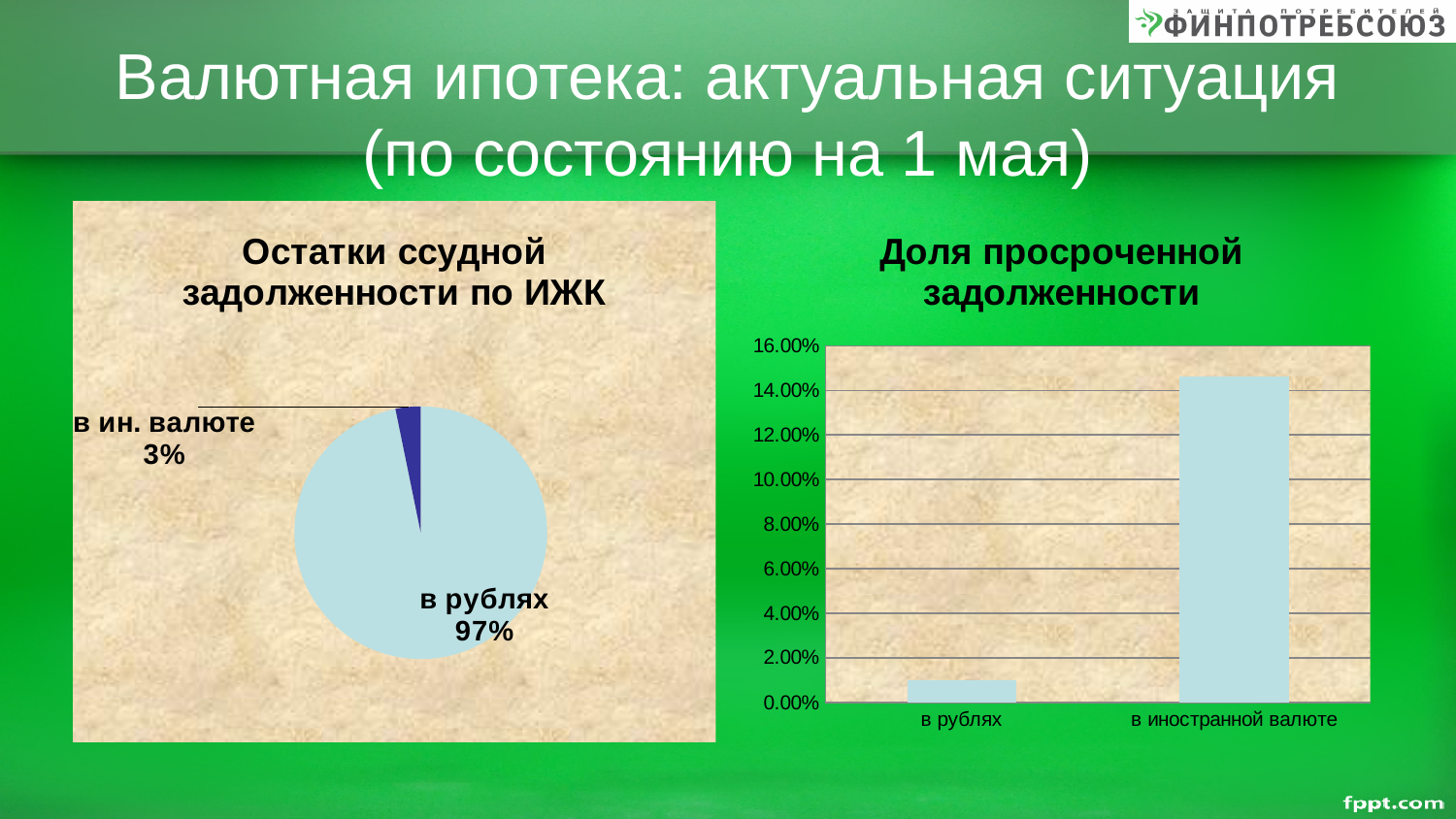
In the pie chart 'Остатки ссудной задолженности по ИЖК', what share is 'в ин. валюте'? 3% In the bar chart 'Доля просроченной задолженности', is the value for 'в иностранной валюте' greater or less than 14.00%? greater In the bar chart 'Доля просроченной задолженности', which category has the higher value? в иностранной валюте In the pie chart 'Остатки ссудной задолженности по ИЖК', which slice is the smallest? в ин. валюте What kind of chart is the right chart, 'Доля просроченной задолженности'? Bar chart What kind of chart is the left chart, 'Остатки ссудной задолженности по ИЖК'? Pie chart In the bar chart 'Доля просроченной задолженности', how many categories are shown on the x axis? 2 In the pie chart 'Остатки ссудной задолженности по ИЖК', how many slices are there? 2 In the pie chart 'Остатки ссудной задолженности по ИЖК', what share is 'в рублях'? 97% In the bar chart 'Доля просроченной задолженности', is the value for 'в рублях' greater or less than 2.00%? less In the pie chart 'Остатки ссудной задолженности по ИЖК', which slice is the largest? в рублях In the pie chart 'Остатки ссудной задолженности по ИЖК', what is the difference in percentage points between 'в рублях' and 'в ин. валюте'? 94 percentage points